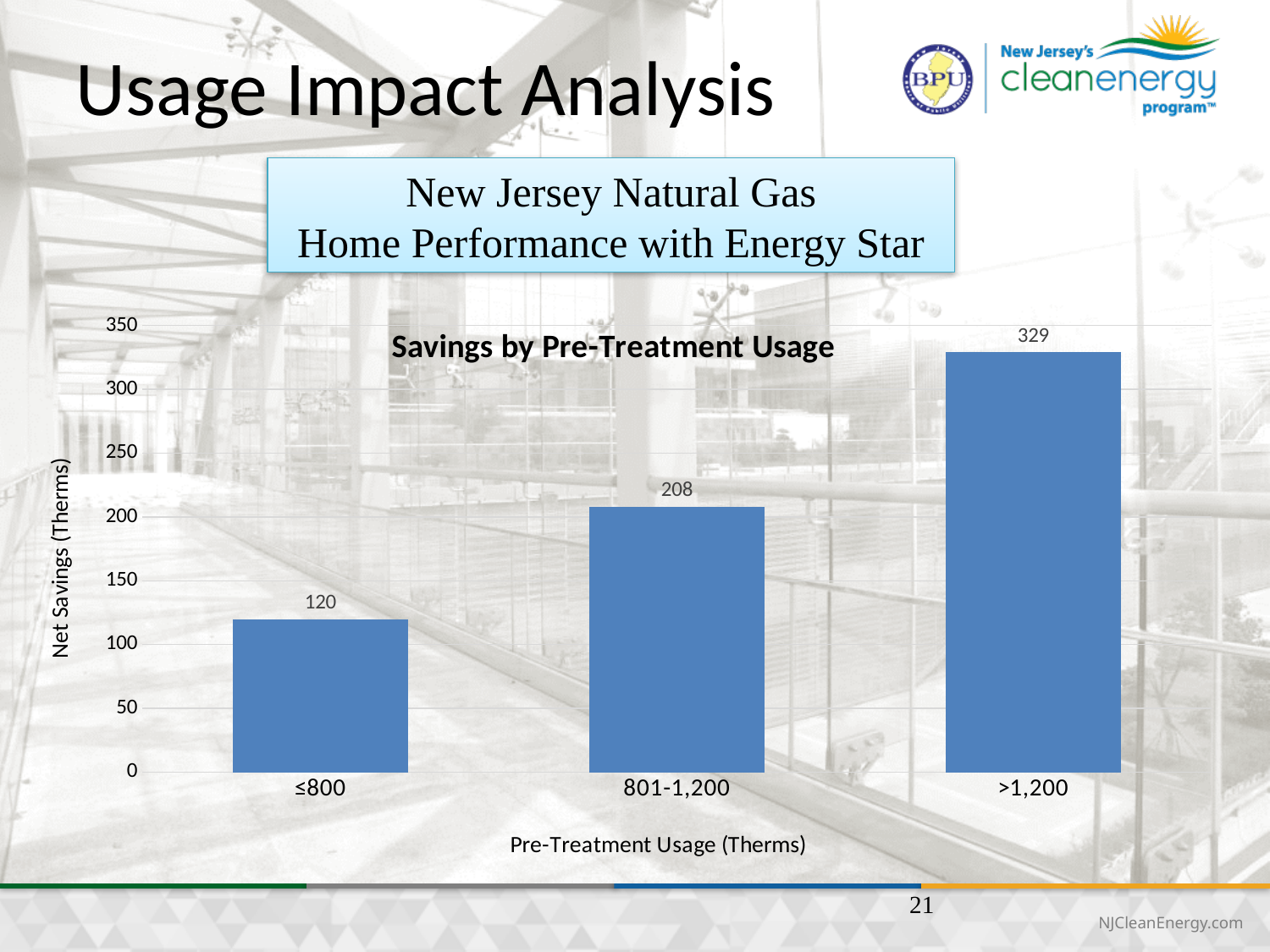
What is the difference in net savings between the 801-1,200 and ≤800 categories? 88 What is the title of the chart? Savings by Pre-Treatment Usage How many pre-treatment usage categories are shown in the chart? 3 What type of chart is shown on the slide? Bar chart Which pre-treatment usage category has the highest net savings? >1,200 What is the net savings value for the ≤800 pre-treatment usage category? 120 Do net savings rise or fall as pre-treatment usage increases along the x axis? Rise What is the net savings value for the >1,200 pre-treatment usage category? 329 What is the net savings value for the 801-1,200 pre-treatment usage category? 208 Which has larger net savings, the 801-1,200 category or the >1,200 category? >1,200 What is the difference in net savings between the >1,200 and ≤800 categories? 209 Which pre-treatment usage category has the lowest net savings? ≤800